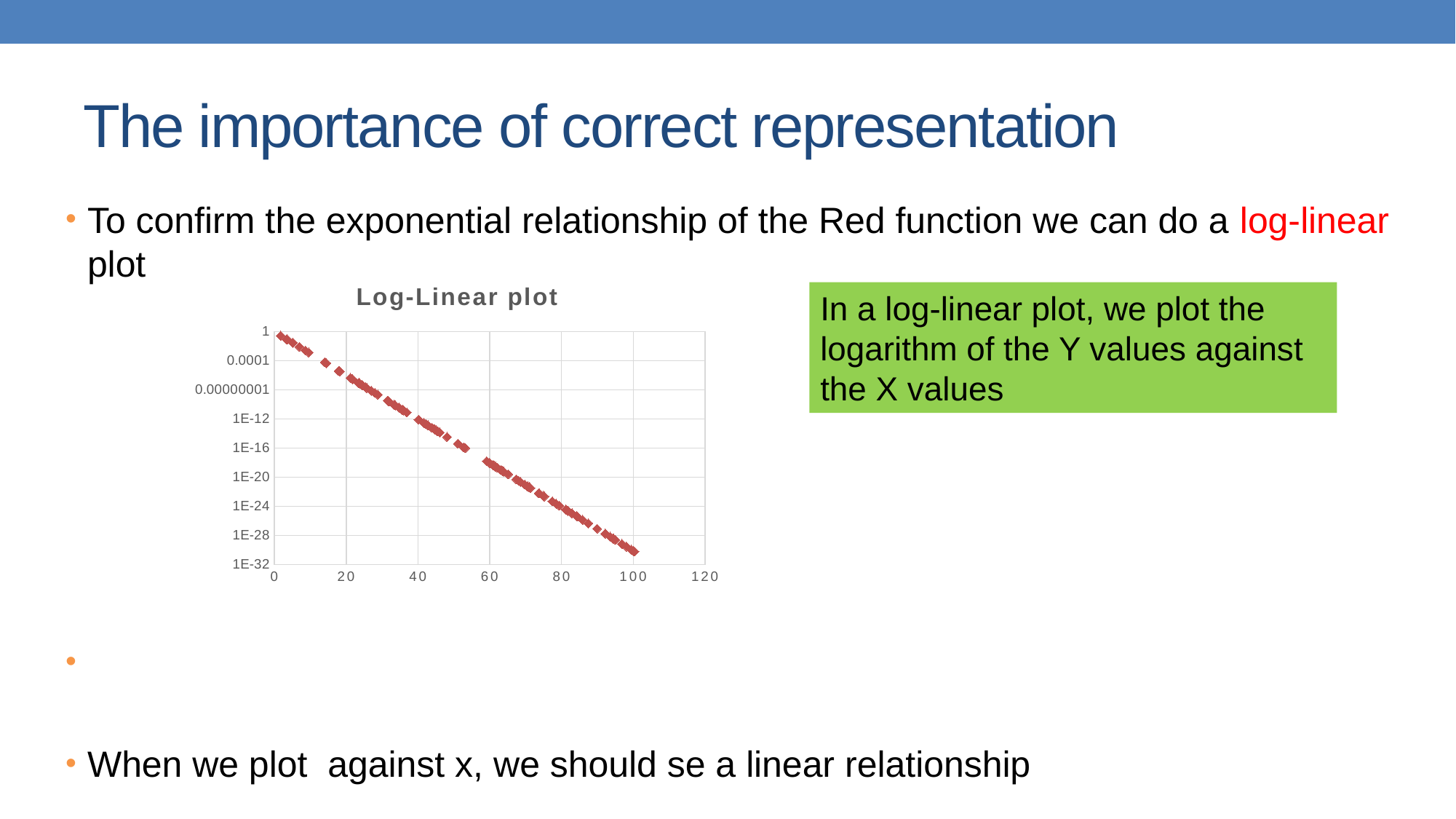
Is the plotted value at x = 80 greater or less than 1E-16? less Is the plotted value at x = 100 greater or less than 1E-20? less What is the highest tick label shown on the x axis? 120 What kind of chart is shown on the slide? scatter plot How many tick labels are shown on the y axis? 9 Is the plotted value at x = 20 greater or less than 1E-16? greater What is the lowest tick label shown on the y axis? 1E-32 What is the highest tick label shown on the y axis? 1 Do the plotted values rise or fall as x increases? fall What is the title of the chart? Log-Linear plot